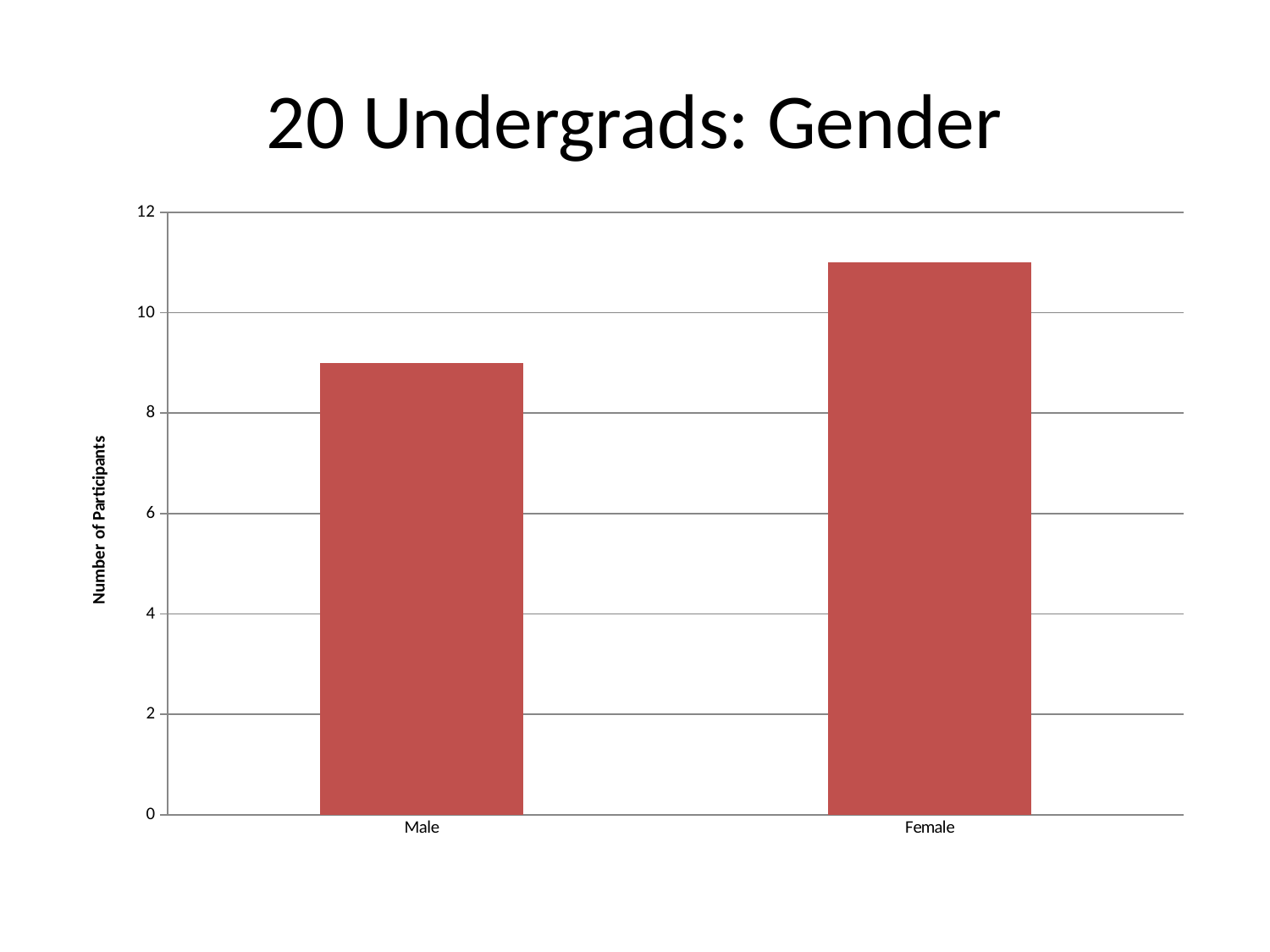
Which is larger, the value for Male or the value for Female? Female Which category has the highest number of participants? Female Is the value for Male greater or less than 8? greater What is the label on the vertical axis? Number of Participants How many categories are shown on the x axis? 2 Is the value for Male greater or less than 10? less What is the title of the chart? 20 Undergrads: Gender Which category has the lowest number of participants? Male What kind of chart is shown on the slide? bar chart Is the value for Female greater or less than 12? less